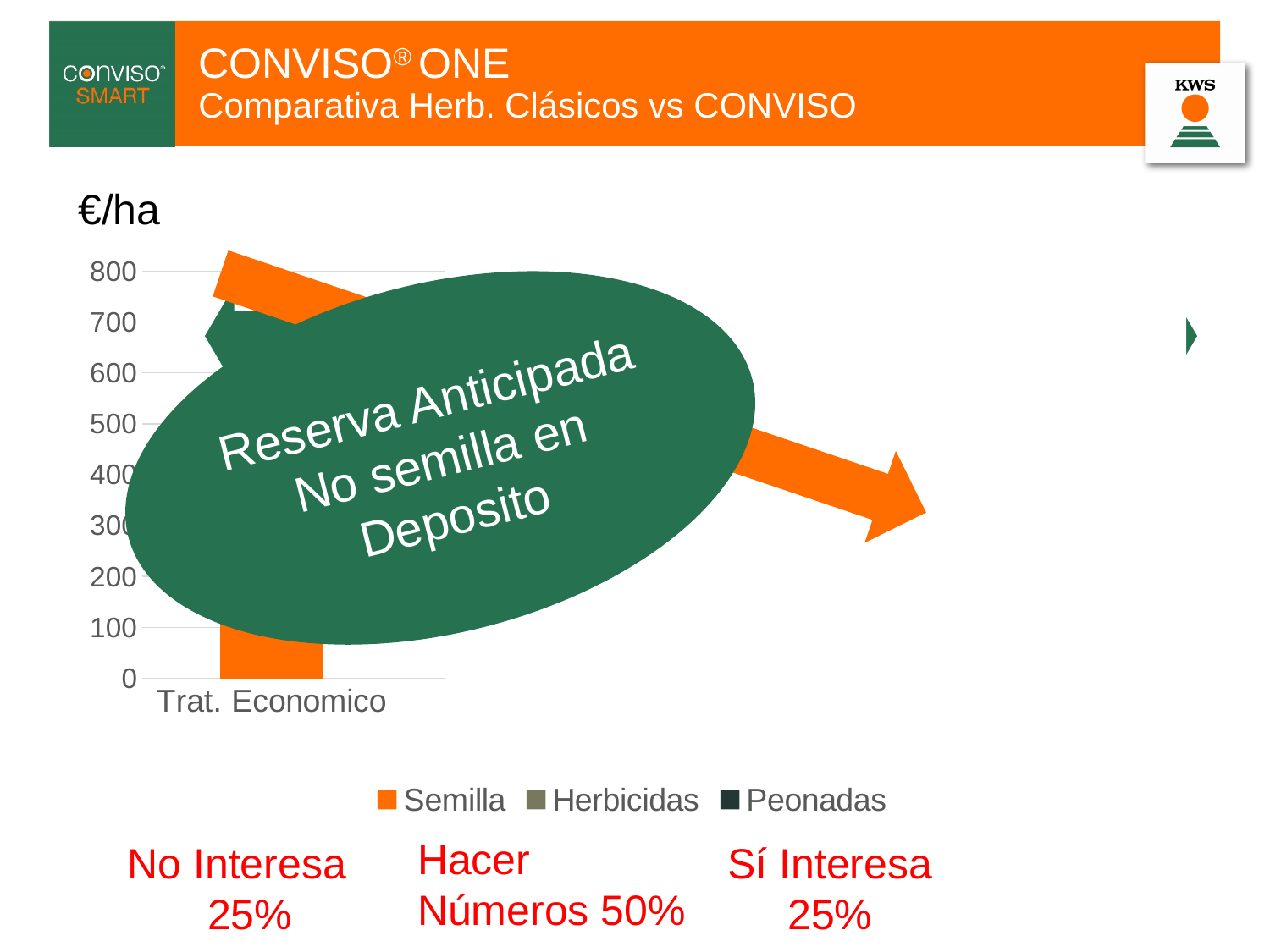
What is the highest tick value shown on the y axis of the chart? 800 How many series does the chart legend list? 3 Which series is shown in orange in the chart? Semilla What unit is shown above the y axis of the chart? €/ha What is the name of the category whose label is readable on the x axis of the chart? Trat. Economico What are the series names listed in the chart legend? Semilla, Herbicidas, Peonadas What kind of chart is shown on the slide? bar chart Is the total height of the stacked bar for Trat. Economico greater or less than 400? greater